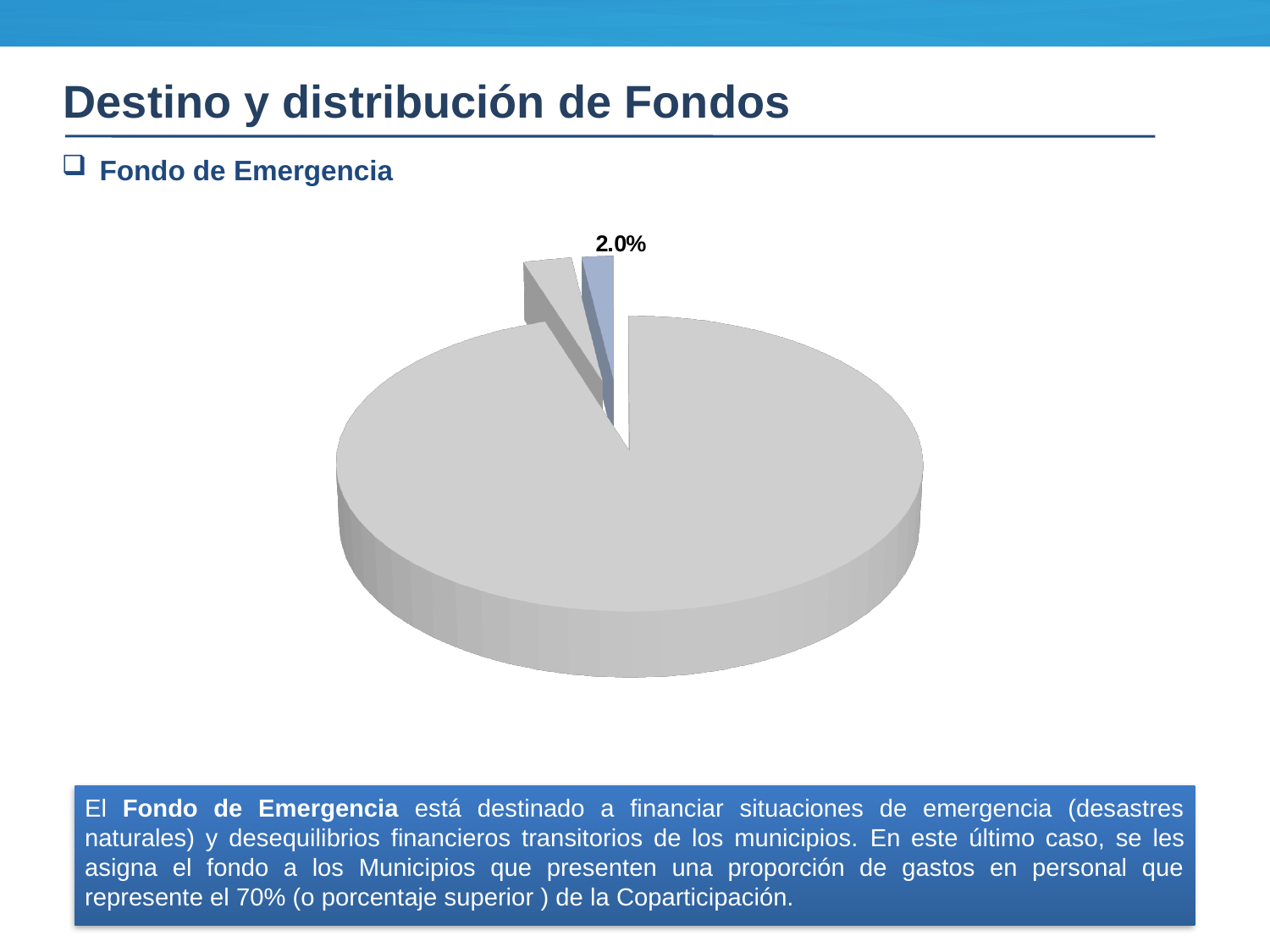
What kind of chart is shown on the slide? pie chart Is the slice labeled 2.0% the largest or the smallest slice of the pie chart? smallest What colour is the slice labeled 2.0%? blue How many data labels are printed on the pie chart? 1 Is the slice labeled 2.0% larger or smaller than the large grey slice? smaller Does the pie chart have a legend? No What value is printed on the data label of the blue slice of the pie chart? 2.0%